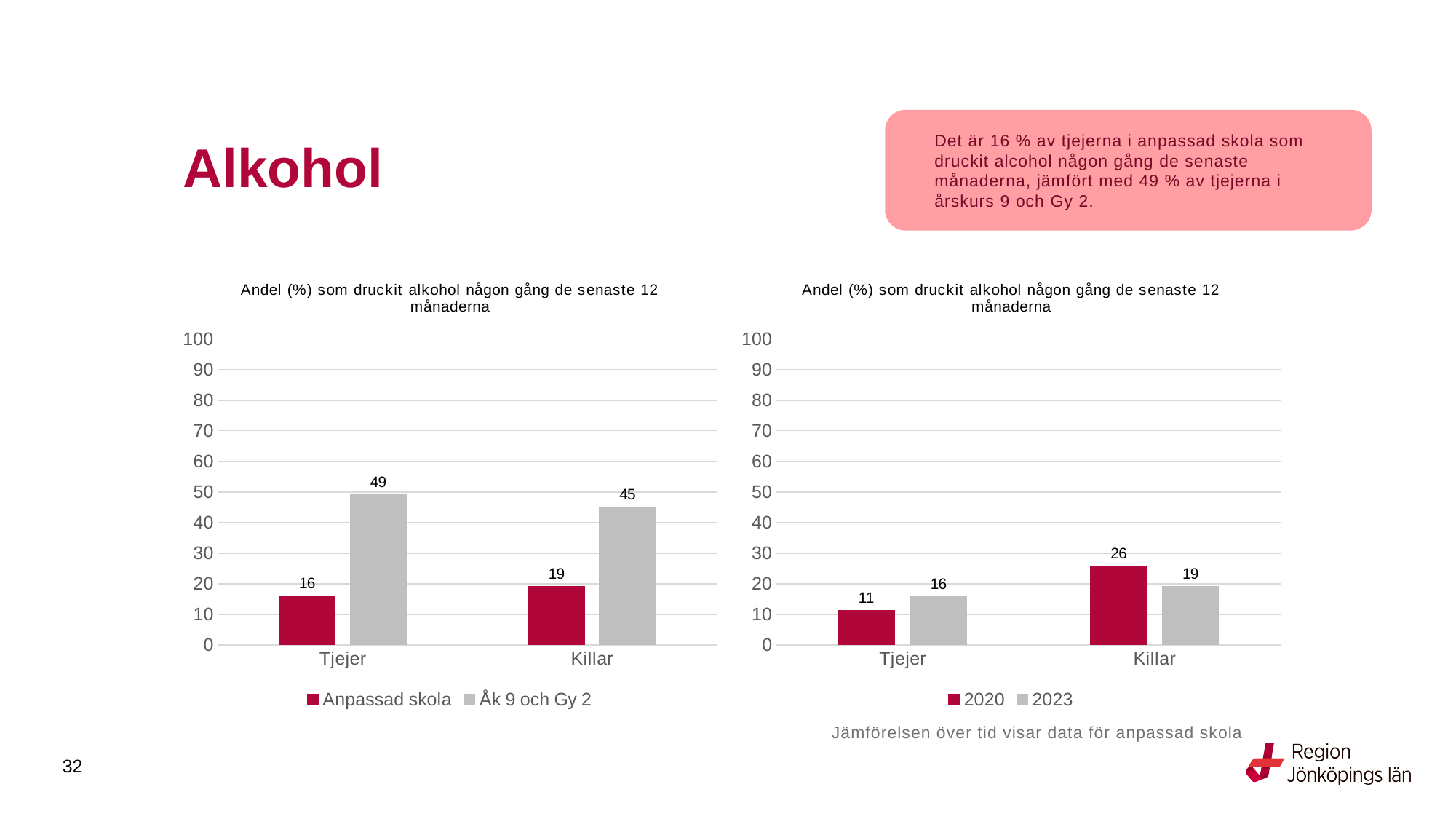
In the right chart, what is the value for Tjejer in 2023? 16 In the right chart, which is larger for Killar: the 2020 value or the 2023 value? 2020 In the left chart, what is the value for Tjejer in the Anpassad skola series? 16 In the left chart, what is the difference between the Åk 9 och Gy 2 value and the Anpassad skola value for Tjejer? 33 In the right chart, what is the value for Killar in 2020? 26 What are the two series listed in the legend of the right chart? 2020 and 2023 What kind of chart is the right chart? Bar chart In the left chart, what is the value for Killar in the Åk 9 och Gy 2 series? 45 How many series does the legend of the left chart list? 2 In the right chart, which bar has the lowest value? Tjejer, 2020 In the right chart, what is the difference between the 2020 and 2023 values for Killar? 7 In the left chart, which bar has the highest value? Tjejer, Åk 9 och Gy 2